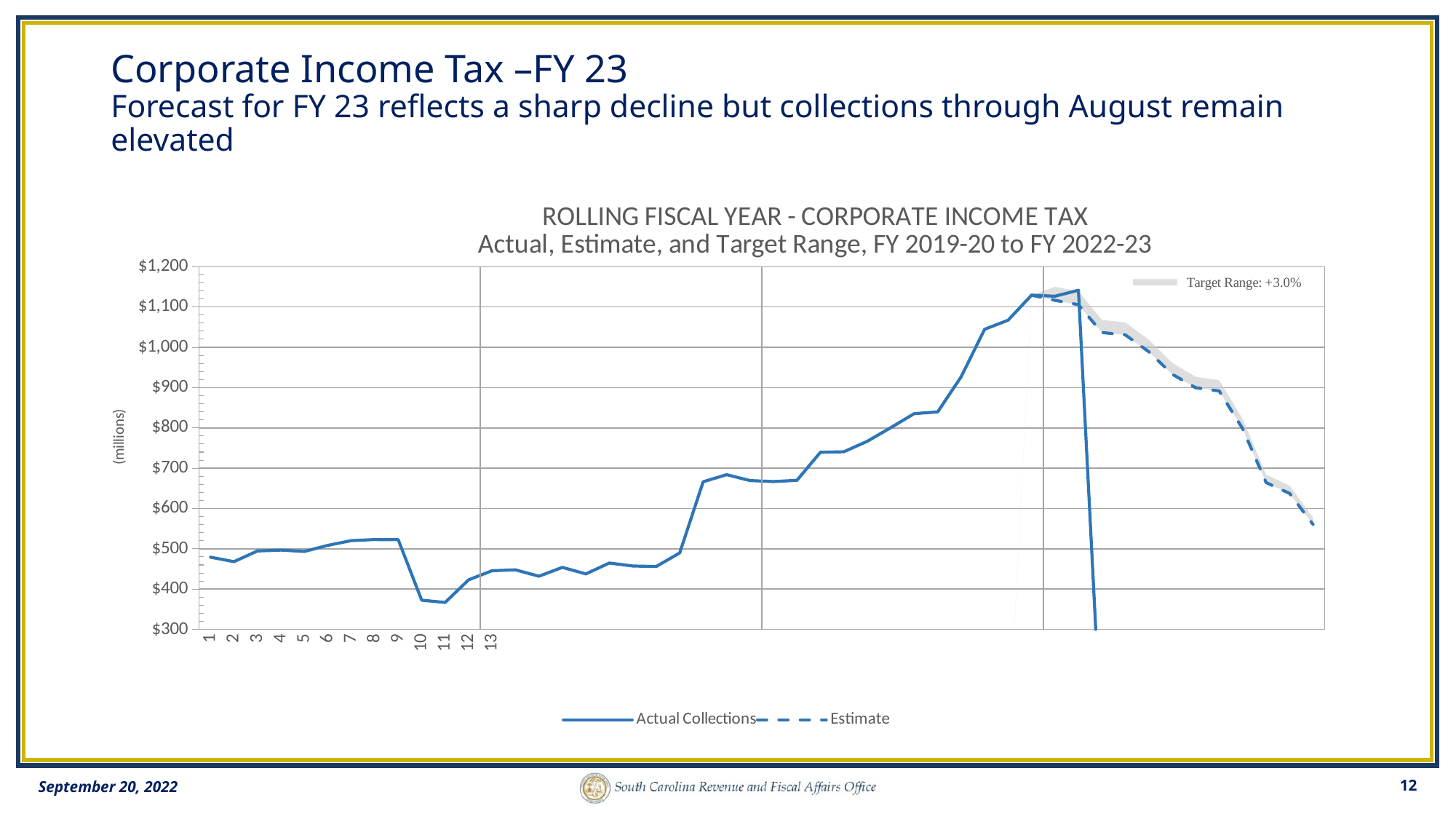
Which is larger, the Actual Collections value at point 9 or at point 10? point 9 Does the Estimate (dashed) line rise or fall as it moves to the right? fall What percentage is given for the Target Range in the chart? +3.0% Is the Actual Collections value at point 1 greater or less than $500? less Is the Actual Collections value at point 9 greater or less than $500? greater Is the Actual Collections value at point 10 greater or less than $400? less How many series does the main legend at the bottom of the chart list? 2 Does the Actual Collections line rise or fall between point 10 and point 13? rise What kind of chart is shown on the slide? line chart What are the two series named in the legend at the bottom of the chart? Actual Collections and Estimate